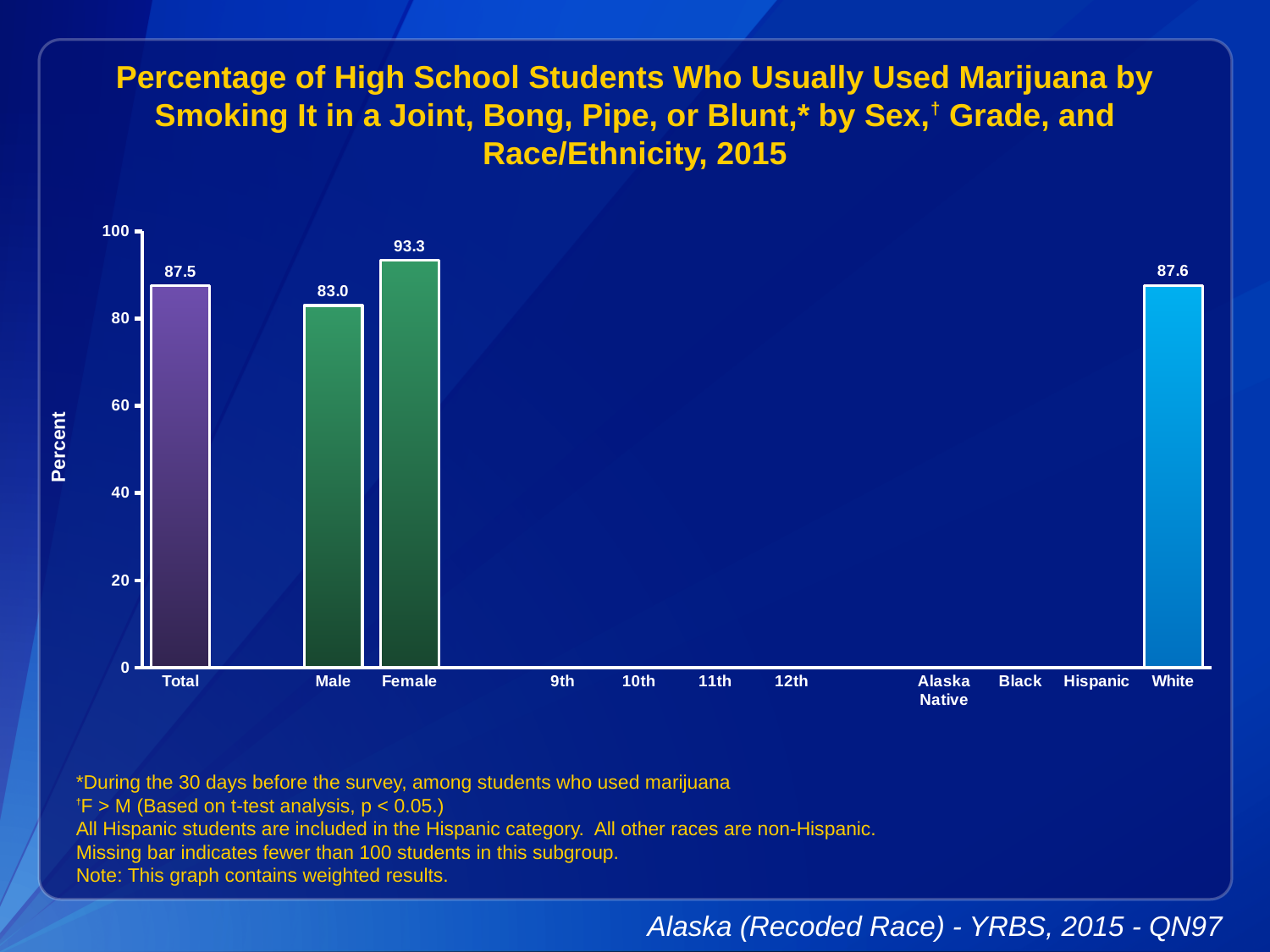
What is the value for Total? 87.5 Is the value for Male greater or less than 80? greater What kind of chart is shown? Bar chart What is the label on the y axis? Percent Which is larger, the value for Male or the value for Female? Female What is the value for Male? 83.0 What is the value for White? 87.6 Which category has the highest value? Female How many categories have a bar plotted? 4 What is the difference between the Female and Male values? 10.3 Which category with a bar has the lowest value? Male What is the value for Female? 93.3